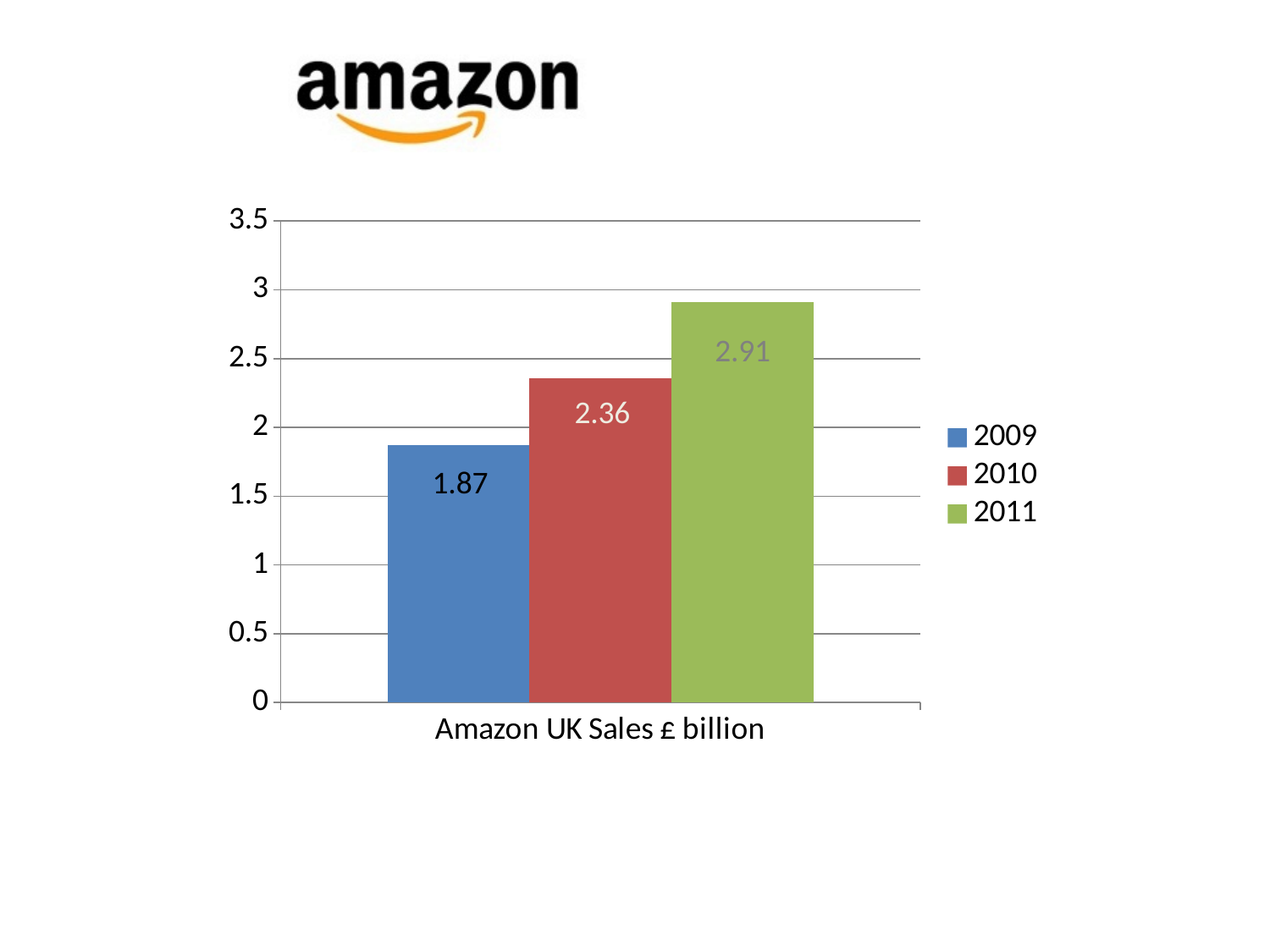
Do the values rise or fall from 2009 to 2011? rise Is the value for 2011 greater or less than 3? less Which is larger, the value for 2010 or the value for 2011? 2011 What is the difference between the 2011 and 2009 values? 1.04 Which year has the highest Amazon UK sales? 2011 Which year has the lowest Amazon UK sales? 2009 What is the value for 2011 in the Amazon UK Sales £ billion chart? 2.91 What is the difference between the 2010 and 2009 values? 0.49 What is the value for 2010 in the Amazon UK Sales £ billion chart? 2.36 What is the value for 2009 in the Amazon UK Sales £ billion chart? 1.87 How many series does the legend list? 3 What kind of chart is shown on the slide? bar chart